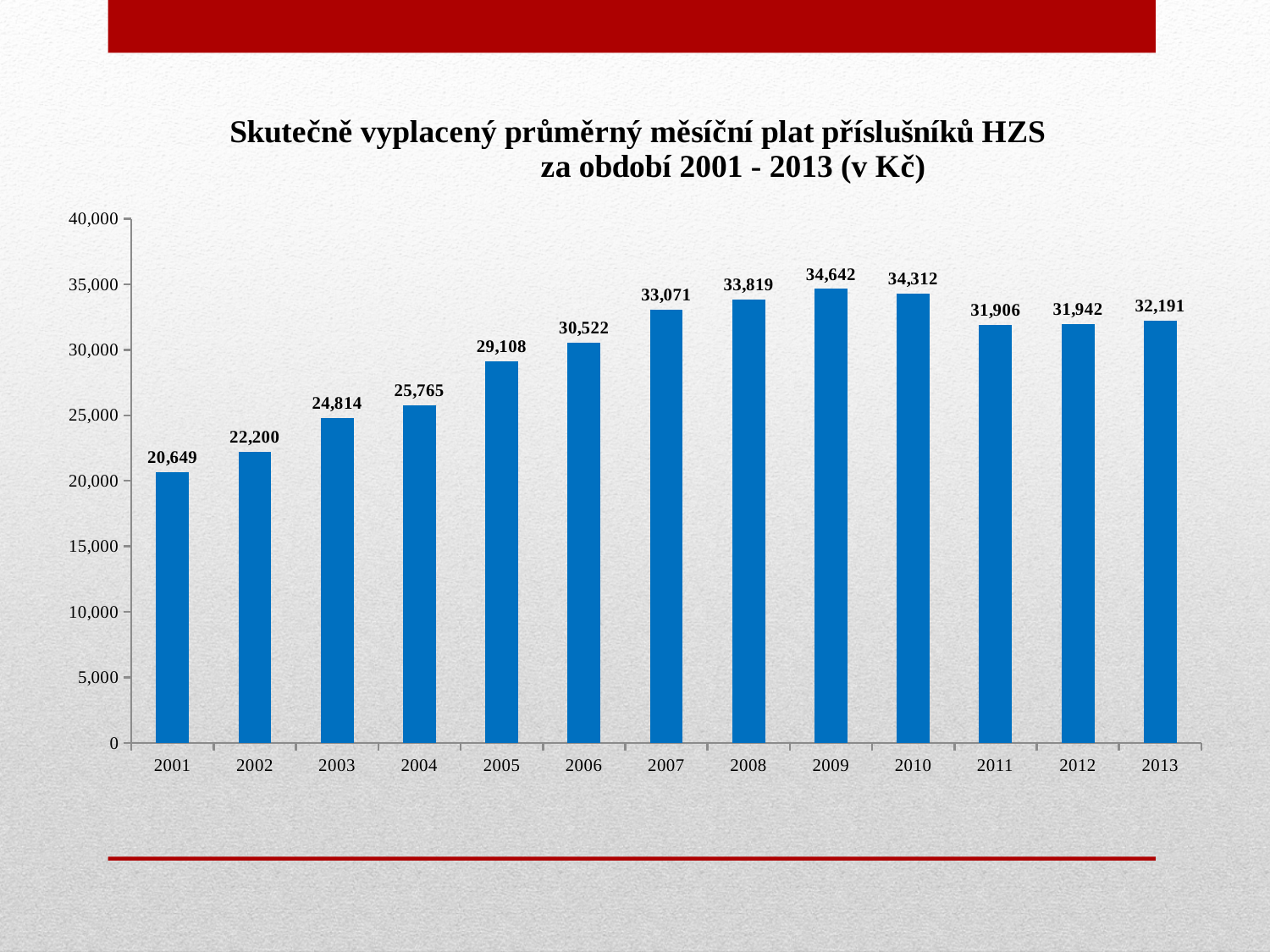
What is the value for 2001? 20,649 Is the value for 2006 greater or less than 30,000? greater Which year has the highest value? 2009 What kind of chart is this? bar chart Which is larger, the value for 2008 or the value for 2012? 2008 What is the difference between the values for 2010 and 2011? 2,406 Do the values rise or fall from 2001 to 2009? rise How many years are shown on the x axis? 13 Which year has the lowest value? 2001 What is the difference between the values for 2009 and 2001? 13,993 What is the value for 2013? 32,191 What is the value for 2009? 34,642